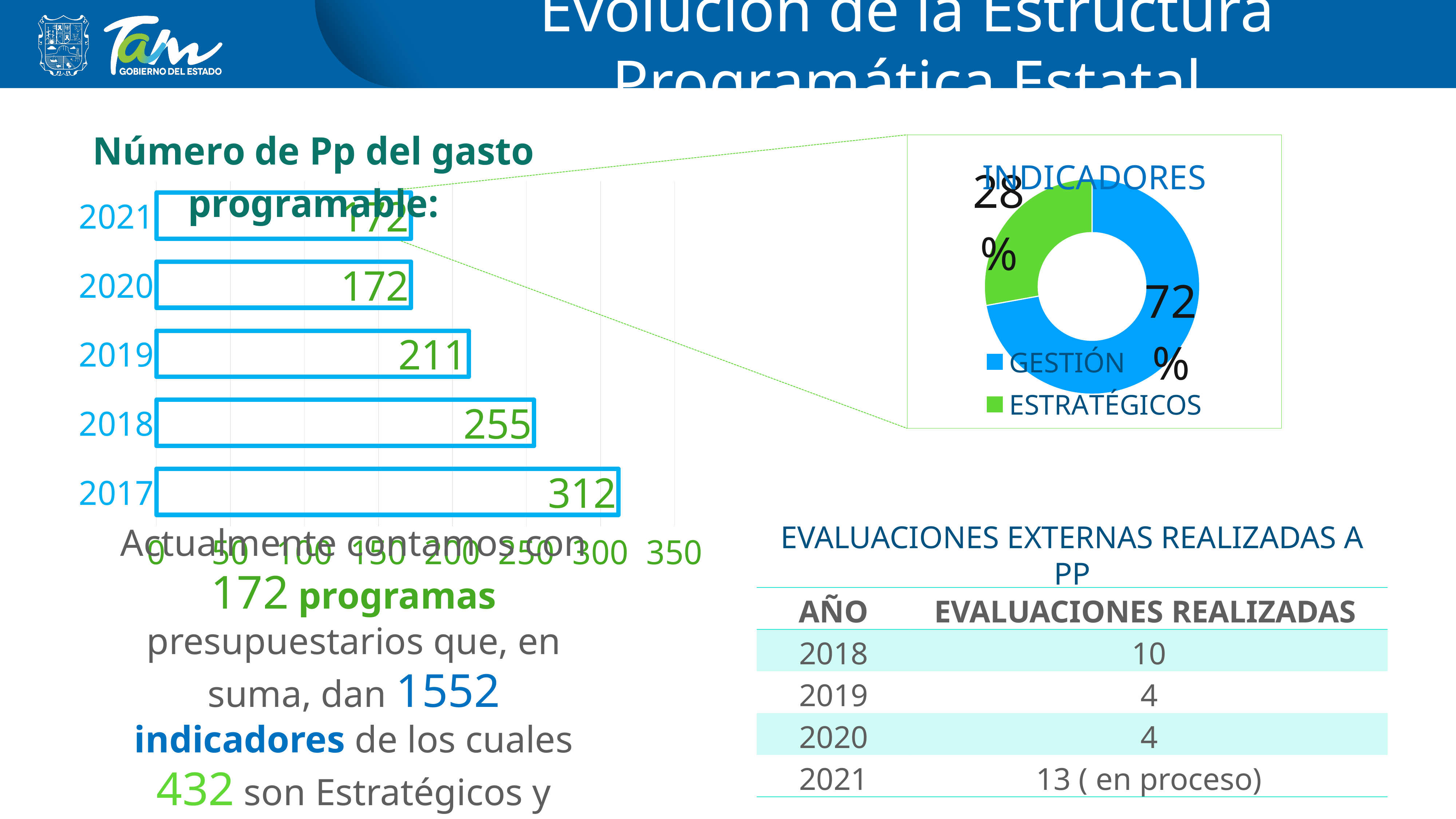
In the bar chart 'Número de Pp del gasto programable', what is the value for 2020? 172 In the bar chart 'Número de Pp del gasto programable', what is the difference between the values for 2017 and 2018? 57 In the bar chart 'Número de Pp del gasto programable', which is larger, the value for 2018 or the value for 2019? 2018 In the 'INDICADORES' doughnut chart, what share is GESTIÓN? 72% How many series does the legend of the 'INDICADORES' chart list? 2 In the bar chart 'Número de Pp del gasto programable', do the values rise or fall from 2017 to 2020? fall In the bar chart 'Número de Pp del gasto programable', what is the value for 2019? 211 In the bar chart 'Número de Pp del gasto programable', what is the value for 2017? 312 In the 'INDICADORES' doughnut chart, what share is ESTRATÉGICOS? 28% In the bar chart 'Número de Pp del gasto programable', which year has the highest value? 2017 What kind of chart is 'Número de Pp del gasto programable'? bar chart In the bar chart 'Número de Pp del gasto programable', how many years are shown? 5